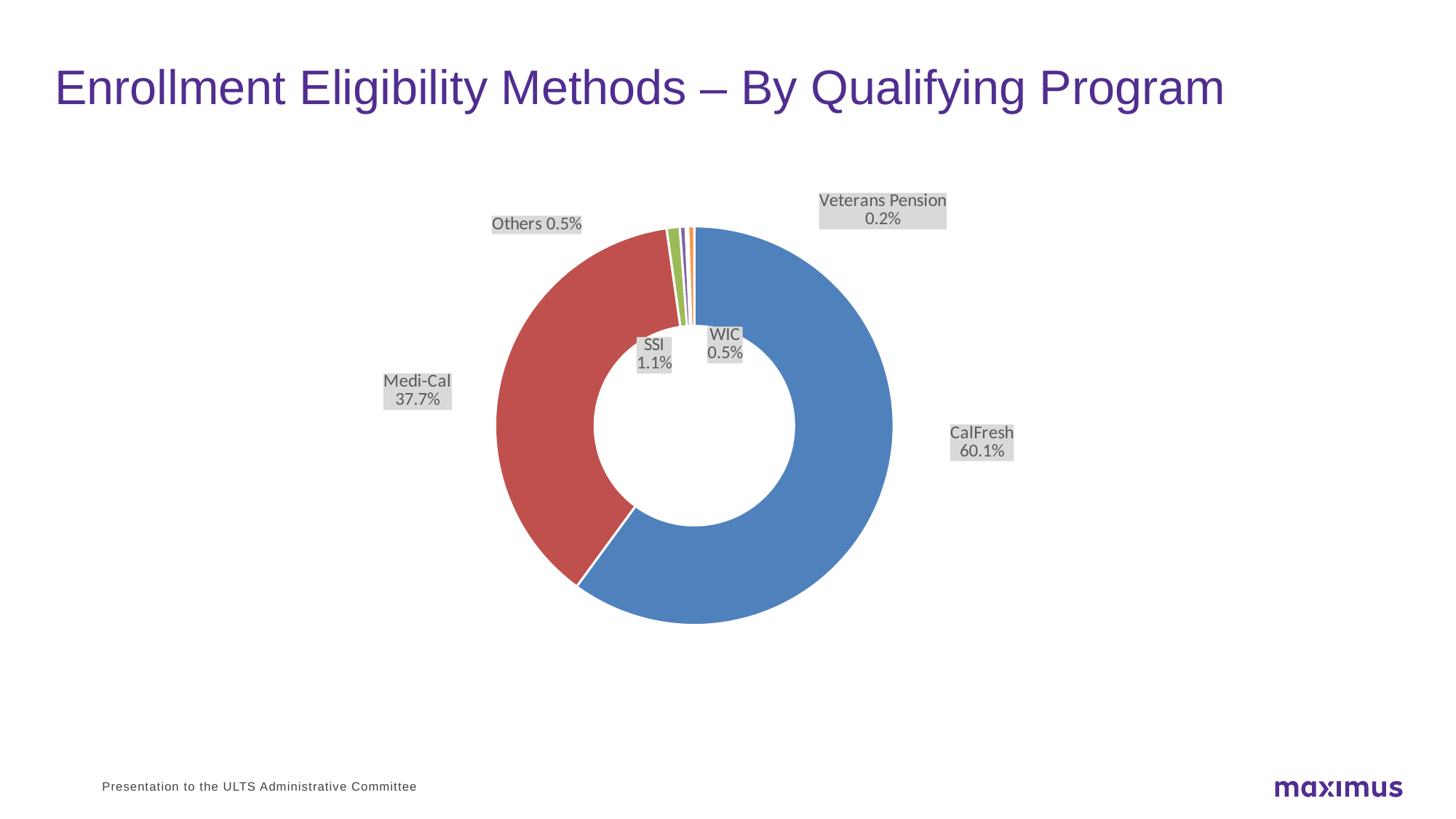
What share of enrollments qualified through WIC? 0.5% What share of enrollments qualified through Medi-Cal? 37.7% What share of enrollments qualified through Veterans Pension? 0.2% What colour is the Medi-Cal segment? Red What share of enrollments qualified through SSI? 1.1% What kind of chart is shown on the slide? Doughnut (pie) chart What share of enrollments qualified through CalFresh? 60.1% What is the difference in percentage points between the CalFresh and Medi-Cal shares? 22.4 Which has a larger share, SSI or WIC? SSI Which qualifying program has the largest share? CalFresh Which qualifying program has the smallest share? Veterans Pension How many qualifying programs are shown in the chart? 6